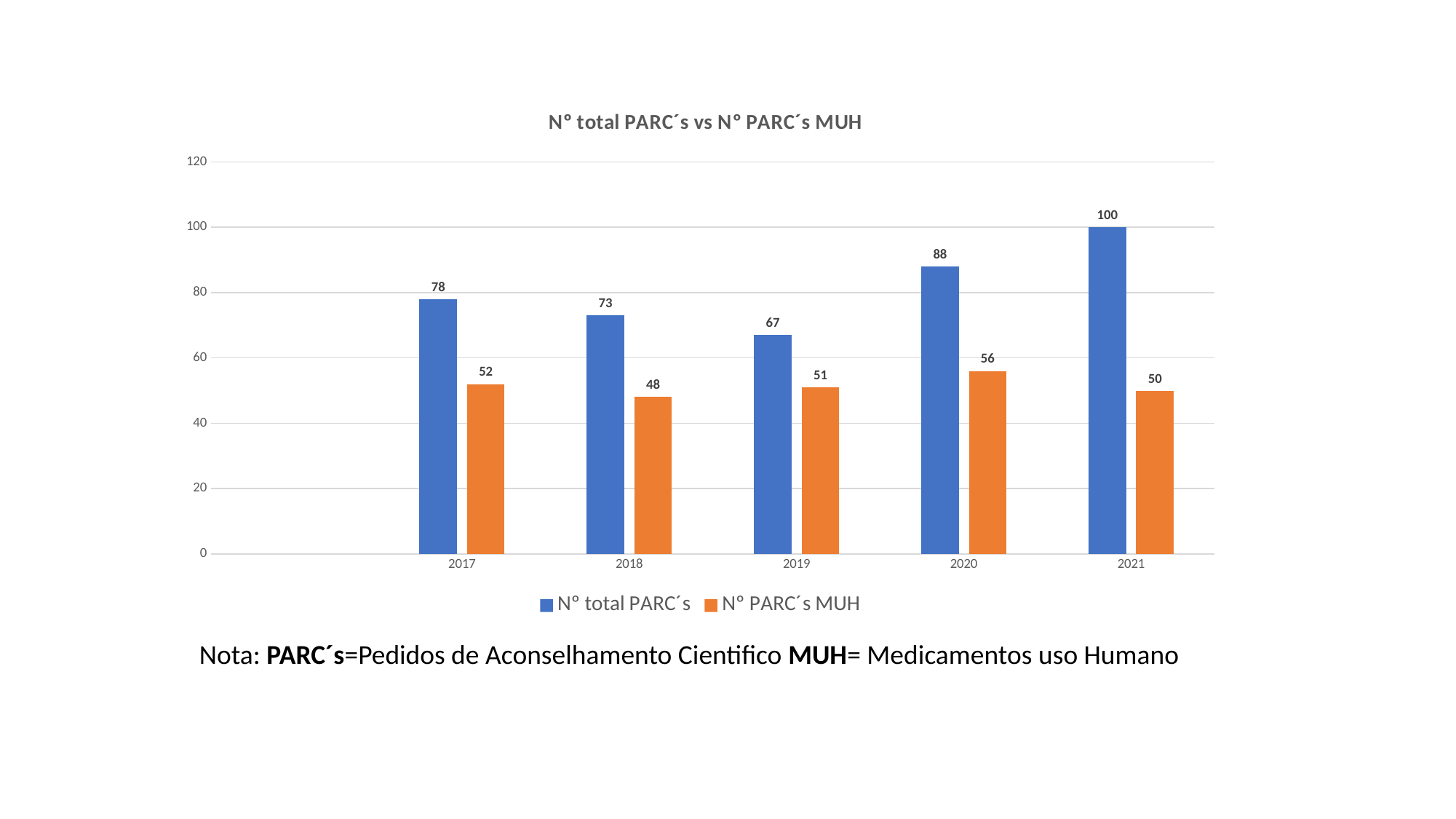
What kind of chart is shown on the slide? bar chart How many years are shown on the x axis? 5 What is the value of N° PARC´s MUH in 2018? 48 What is the difference between N° total PARC´s and N° PARC´s MUH in 2020? 32 Is the value for N° total PARC´s in 2019 greater or less than 60? greater How many series does the legend list? 2 Which is larger: N° PARC´s MUH in 2017 or N° PARC´s MUH in 2021? N° PARC´s MUH in 2017 Which year has the lowest value for N° PARC´s MUH? 2018 Which year has the highest value for N° total PARC´s? 2021 What is the value of N° total PARC´s in 2021? 100 What is the title of the chart? N° total PARC´s vs N° PARC´s MUH Do the values for N° total PARC´s rise or fall from 2019 to 2021? rise